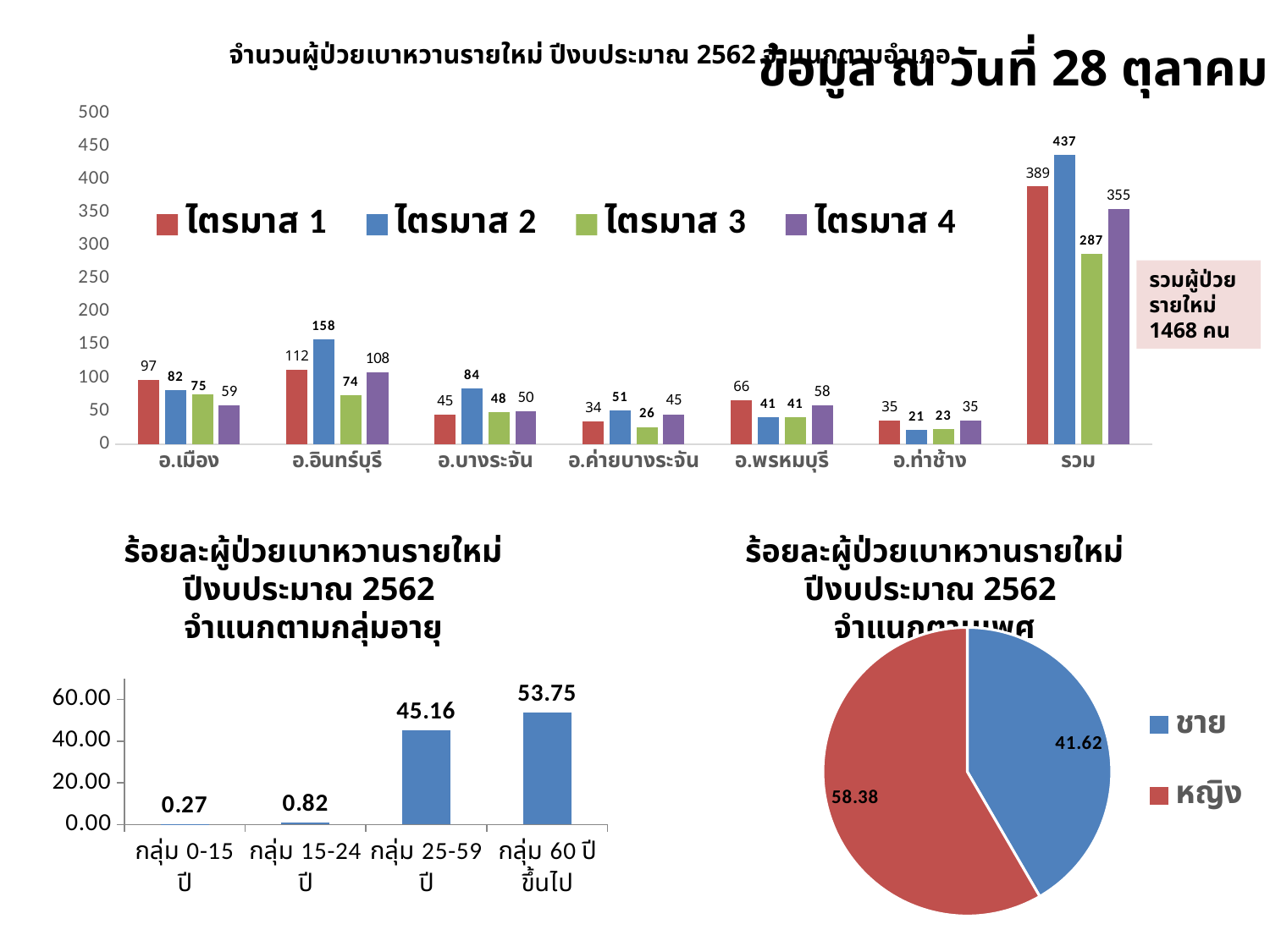
In the bottom-left bar chart, do the values rise or fall from left to right along the x axis? rise In the top bar chart, which is larger for ไตรมาส 1: อ.เมือง or อ.อินทร์บุรี? อ.อินทร์บุรี In the top bar chart (จำนวนผู้ป่วยเบาหวานรายใหม่ ปีงบประมาณ 2562 จำแนกตามอำเภอ), what is the value for ไตรมาส 2 in อ.อินทร์บุรี? 158 In the top bar chart, what is the value for ไตรมาส 4 in อ.พรหมบุรี? 58 How many categories are shown on the x axis of the top bar chart? 7 How many series does the legend of the top bar chart list? 4 In the bottom-left bar chart, which age group has the highest value? กลุ่ม 60 ปีขึ้นไป What kind of chart is the bottom-right chart (ร้อยละผู้ป่วยเบาหวานรายใหม่ จำแนกตามเพศ)? pie chart In the top bar chart, which quarter has the highest value in the รวม category? ไตรมาส 2 In the bottom-left bar chart (ร้อยละผู้ป่วยเบาหวานรายใหม่ จำแนกตามกลุ่มอายุ), what is the value for กลุ่ม 25-59 ปี? 45.16 In the bottom-right pie chart, what share does หญิง have? 58.38 In the top bar chart, what is the difference between ไตรมาส 2 and ไตรมาส 3 in the รวม category? 150